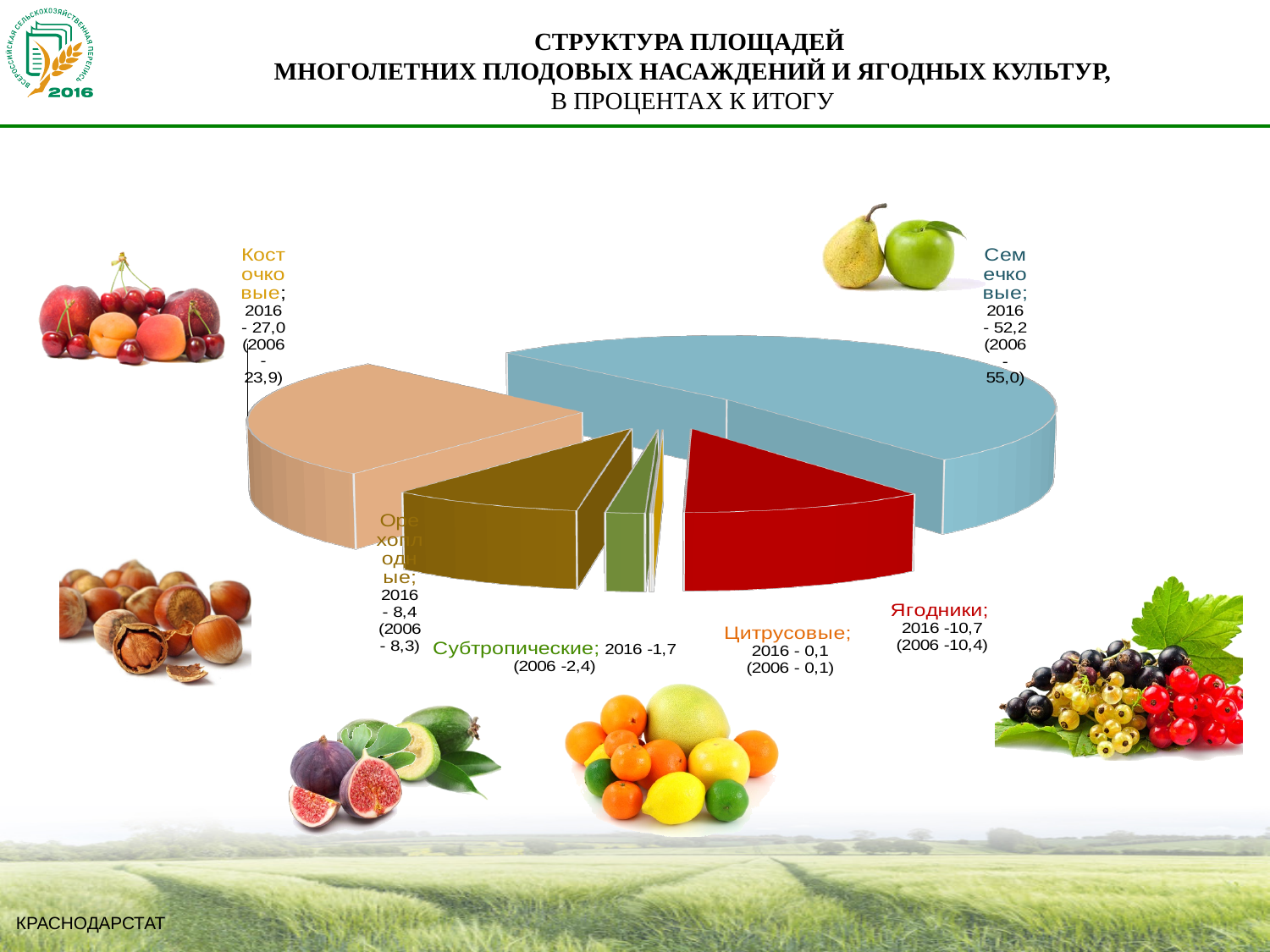
Which category has the largest share in 2016? Семечковые What is the 2016 share for Субтропические? 1,7 What is the 2016 share for Семечковые? 52,2 Which has the larger 2016 share, Ягодники or Орехоплодные? Ягодники What kind of chart is shown on the slide? pie chart What is the 2016 share for Косточковые? 27,0 Which category has the smallest share in 2016? Цитрусовые What was the 2006 share for Орехоплодные? 8,3 What is the difference between the 2016 shares of Косточковые (27,0) and Ягодники (10,7)? 16,3 How many categories (slices) does the pie chart show? 6 What was the 2006 share for Ягодники? 10,4 By how much did the share of Семечковые change from 2006 (55,0) to 2016 (52,2)? 2,8